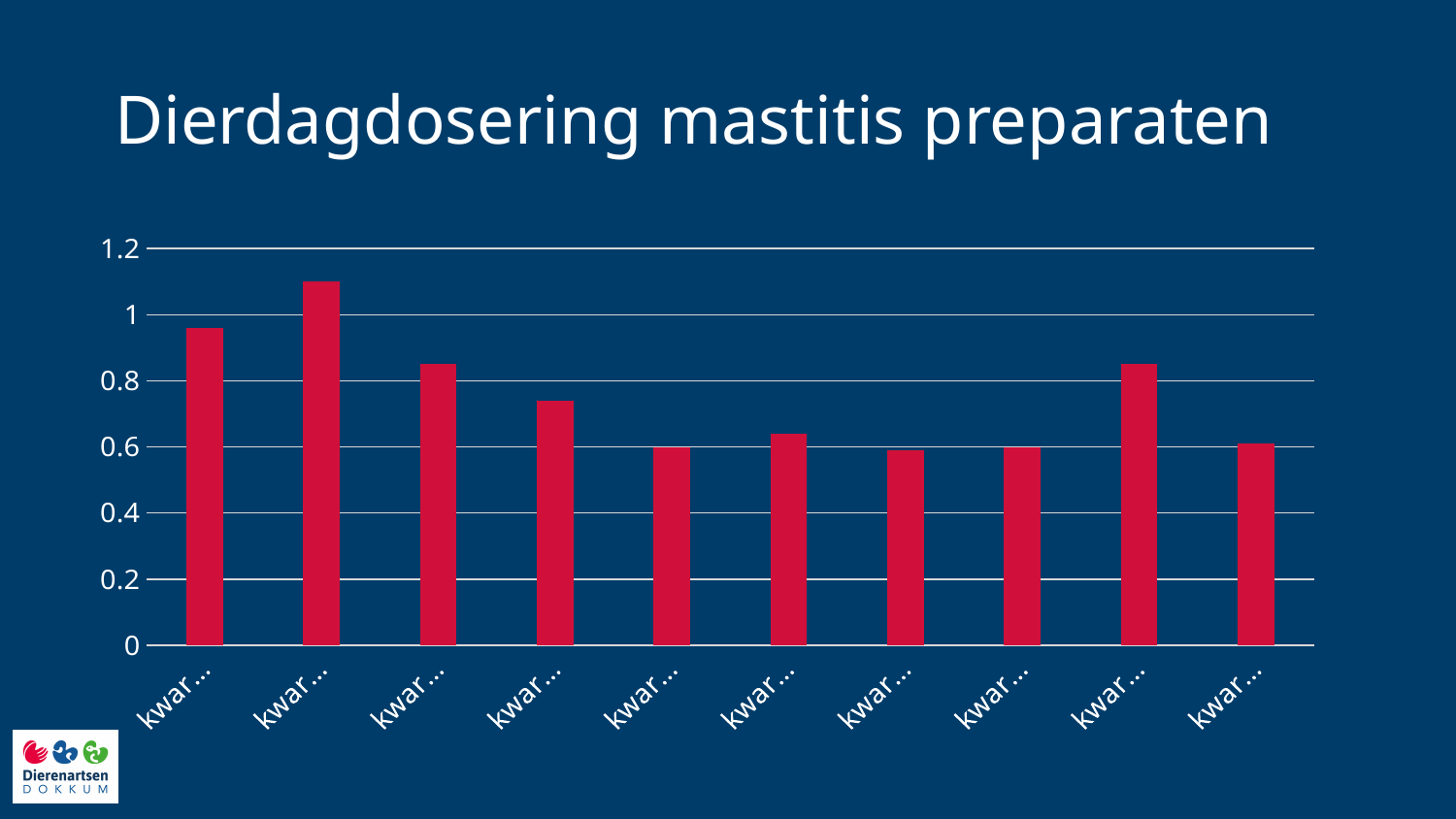
What is the title of the chart? Dierdagdosering mastitis preparaten What is the highest value shown on the vertical axis? 1.2 Which is larger, the value of the third bar or the fourth bar? the third bar What kind of chart is shown on the slide? bar chart Is the value of the first bar greater or less than 1? less Is the value of the second bar greater or less than 1? greater Is the value of the first bar greater or less than 0.8? greater How many bars are plotted in the chart? 10 Which bar is the highest in the chart? the second bar Which is larger, the value of the ninth bar or the tenth bar? the ninth bar